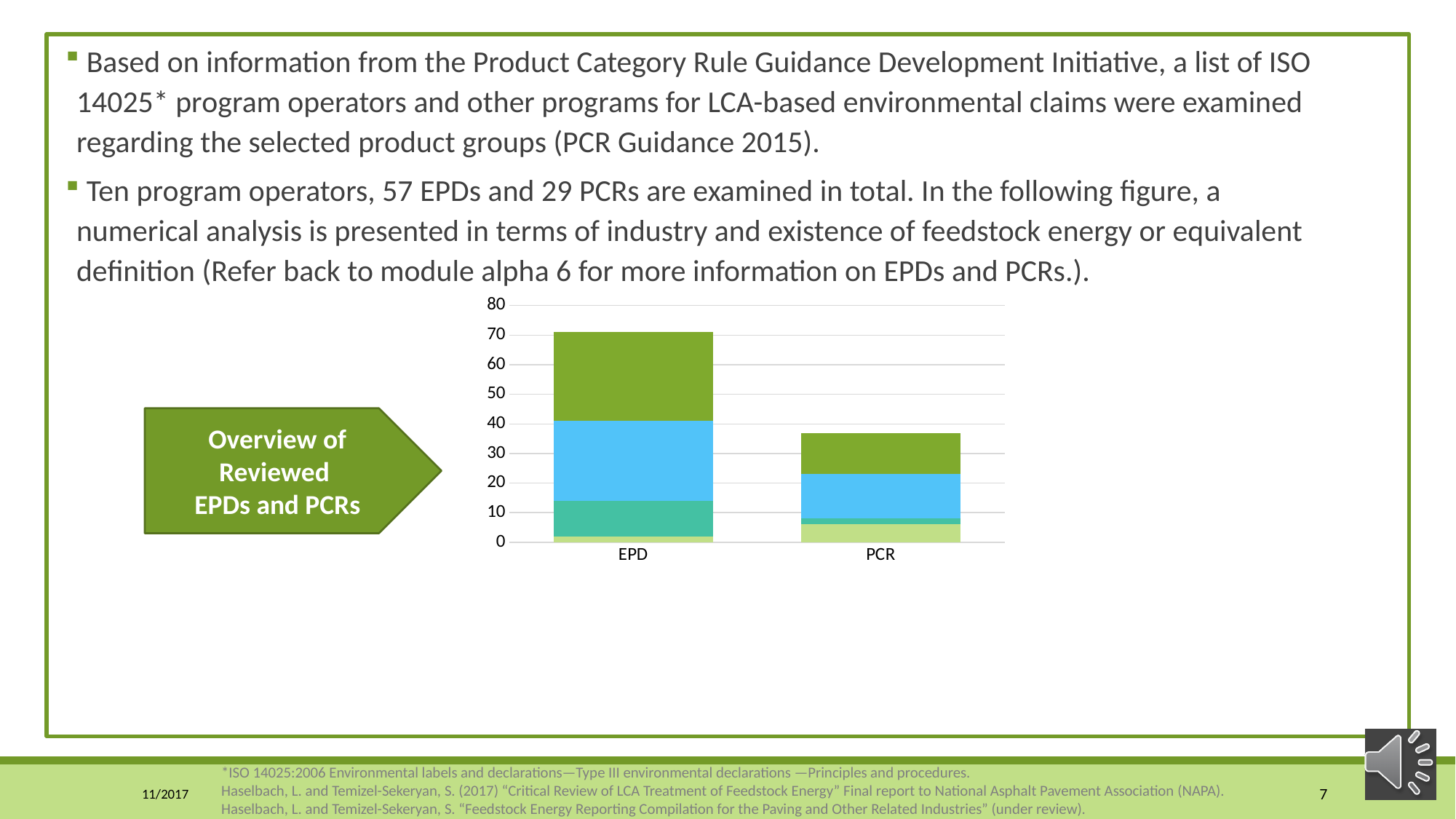
Which category has the lowest total bar height? PCR Which category has the highest total bar height? EPD What are the two category labels on the x axis of the chart? EPD and PCR How many categories are shown on the x axis of the chart? 2 Is the total value for EPD greater or less than 60? greater Is the total value for PCR greater or less than 30? greater Is the total value for EPD greater or less than 50? greater What kind of chart is shown on the slide? stacked bar chart What is the highest value shown on the chart's y axis? 80 Which category has the taller stacked bar, EPD or PCR? EPD